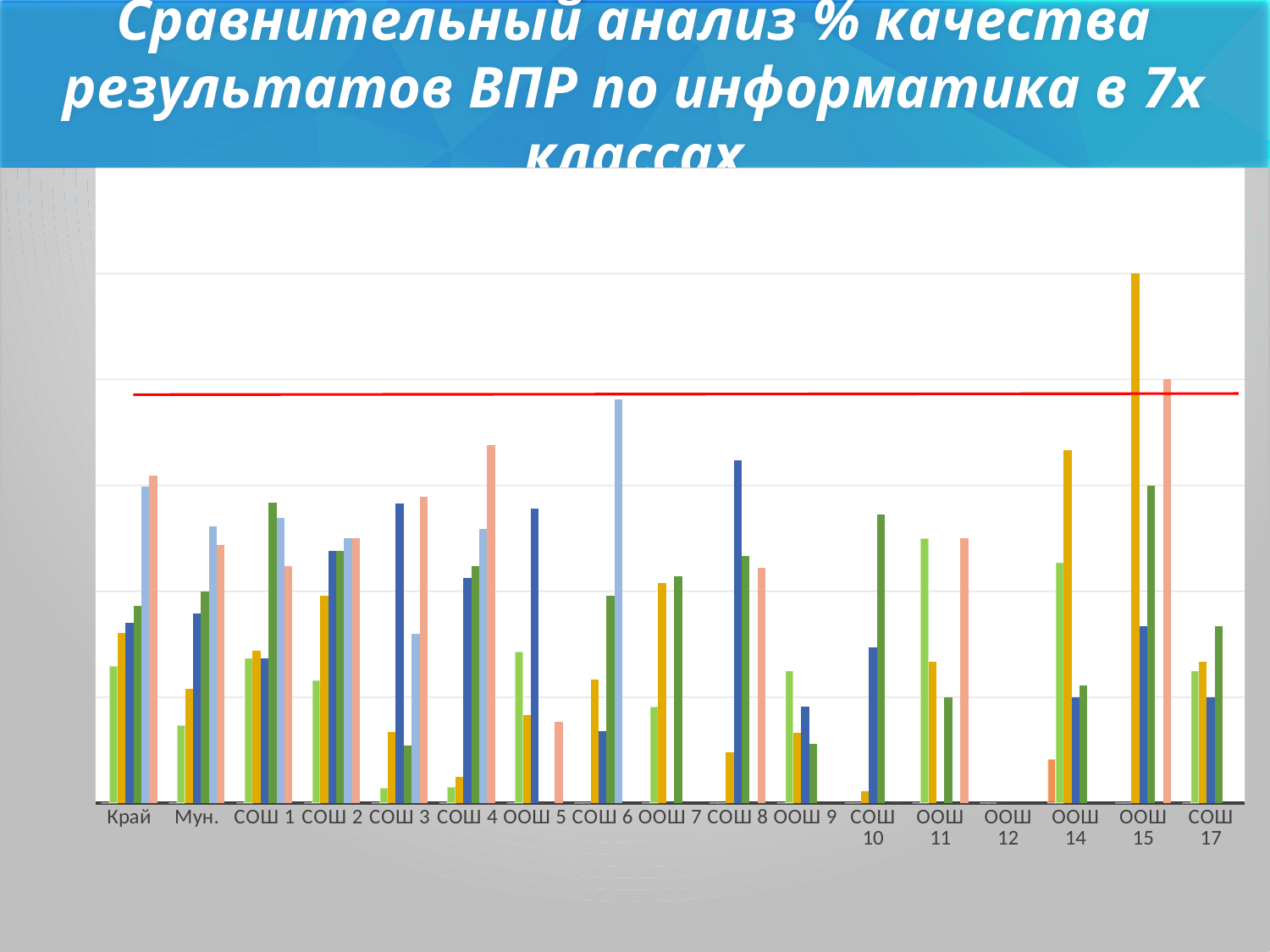
Which category contains the tallest bar on the chart? ООШ 15 Which category on the chart shows no visible bars at all? ООШ 12 Is the tallest bar in ООШ 15 taller or shorter than the tallest bar in СОШ 6? taller What is the first category on the x axis of the chart? Край Which category has the tallest salmon (pink) bar? ООШ 15 What kind of chart is shown on the slide? bar chart How many categories are shown along the x axis of the chart? 17 What colour is the horizontal reference line drawn across the chart? red Which category has the tallest light blue bar? СОШ 6